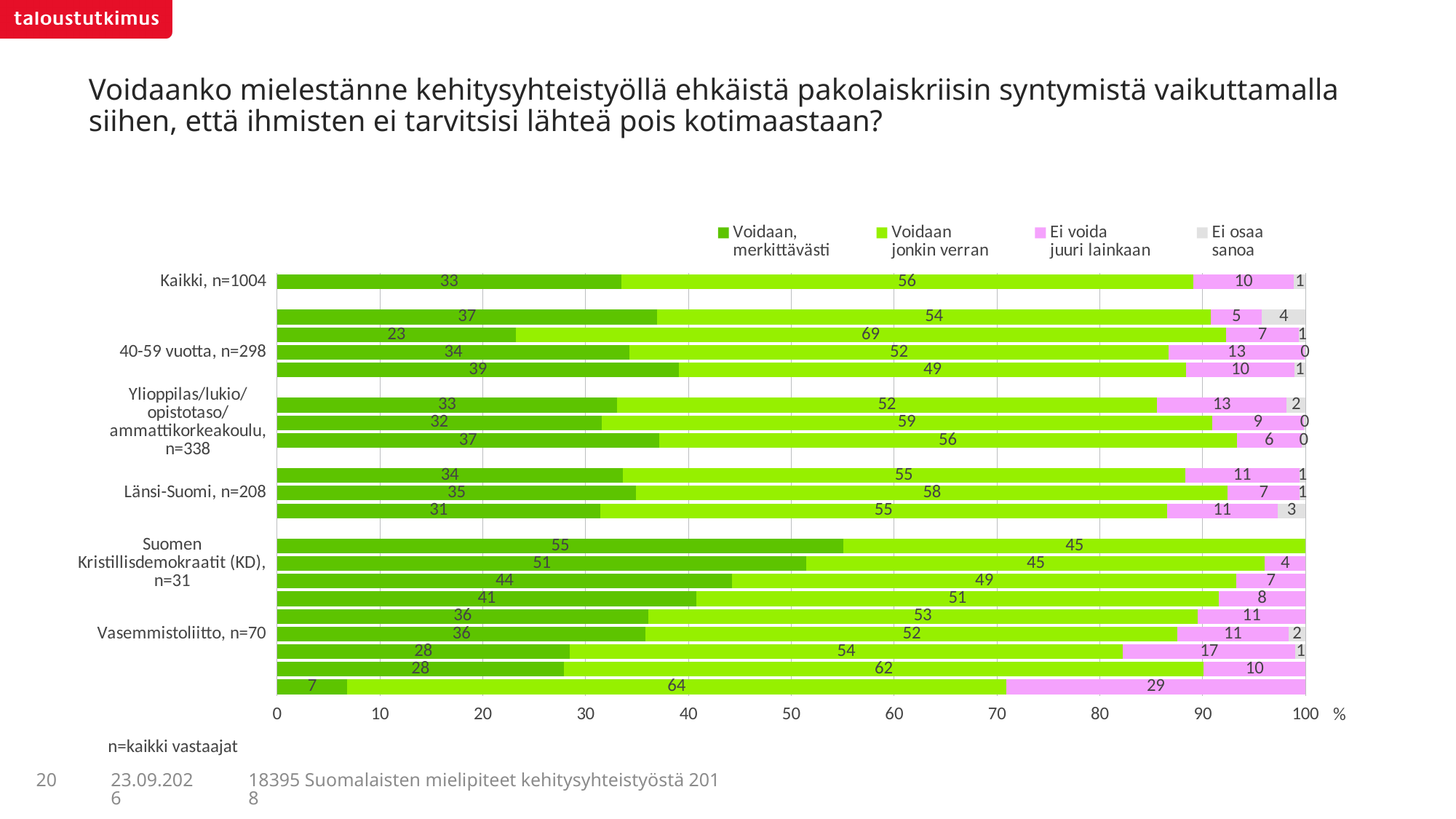
What is the 'Voidaan, merkittävästi' value for Kaikki, n=1004? 33 What is the difference between the 'Voidaan jonkin verran' and 'Voidaan, merkittävästi' values for Kaikki, n=1004? 23 What is the 'Ei osaa sanoa' value for Vasemmistoliitto, n=70? 2 What is the 'Voidaan, merkittävästi' value for Suomen Kristillisdemokraatit (KD), n=31? 51 How many series does the legend list? 4 What is the 'Ei voida juuri lainkaan' value for 40-59 vuotta, n=298? 13 What kind of chart is shown on the slide? Stacked bar chart What is the total of the stacked bar for Kaikki, n=1004? 100 Is the 'Voidaan, merkittävästi' value for Ylioppilas/lukio/opistotaso/ammattikorkeakoulu, n=338 greater or less than 30? greater What is the 'Voidaan jonkin verran' value for Länsi-Suomi, n=208? 58 Which has the larger 'Voidaan, merkittävästi' value: Länsi-Suomi, n=208 or Kaikki, n=1004? Länsi-Suomi, n=208